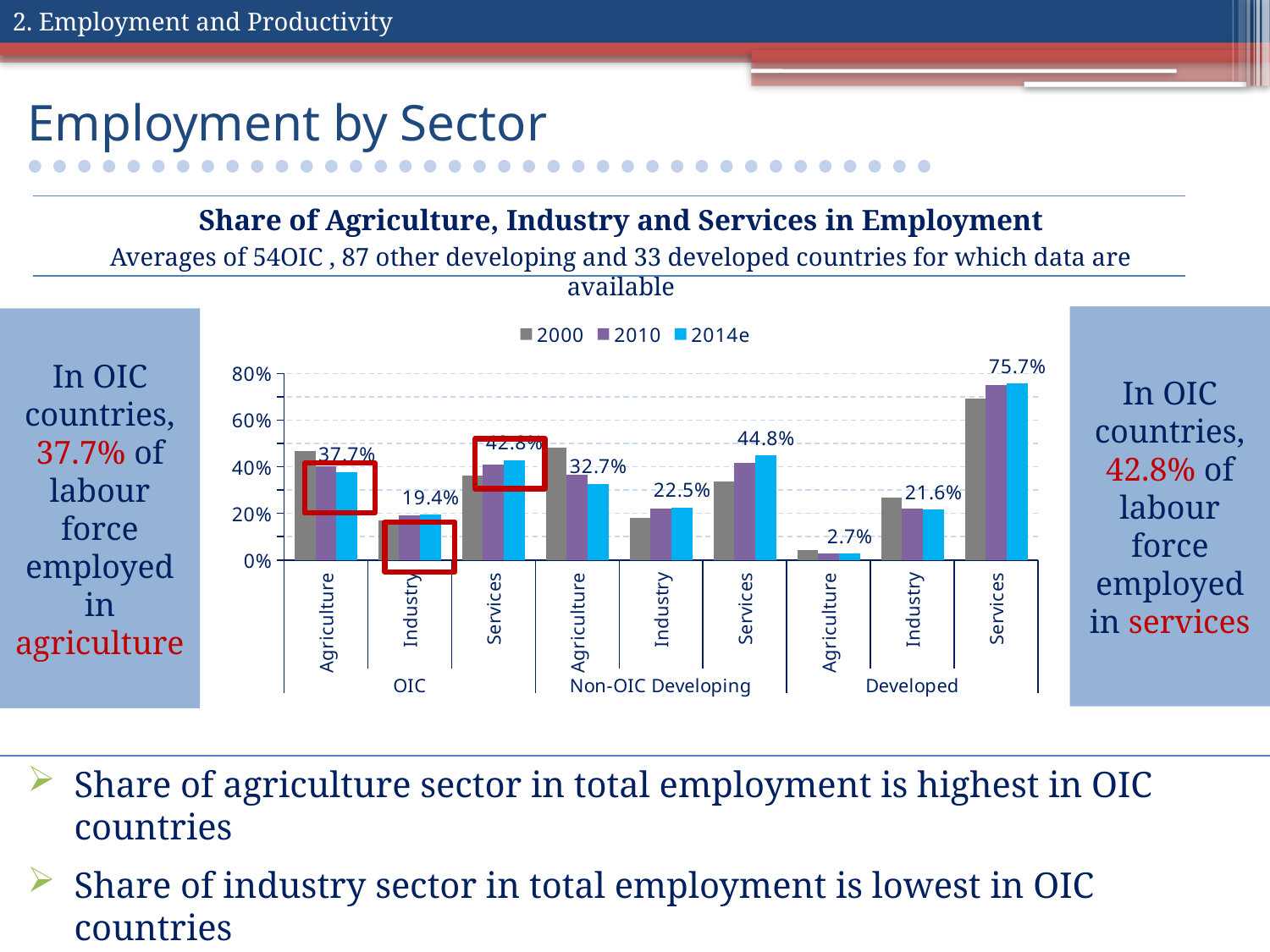
What is the 2014e share of agriculture in employment for OIC countries? 37.7% What is the 2014e share of services in employment for Developed countries? 75.7% What is the 2014e share of agriculture in employment for Developed countries? 2.7% Which country group has the lowest 2014e share of industry in employment? OIC Which series is shown in light blue in the legend? 2014e What is the difference between the 2014e services share in Developed countries (75.7%) and in OIC countries (42.8%)? 32.9% What kind of chart is shown on the slide? bar chart How many series does the chart legend list? 3 Is the 2000 value for services in Developed countries greater or less than 60%? greater Which is larger for 2014e: the agriculture share in OIC countries or in Non-OIC Developing countries? OIC countries Which country group has the highest 2014e share of services in employment? Developed What is the 2014e share of industry in employment for Non-OIC Developing countries? 22.5%